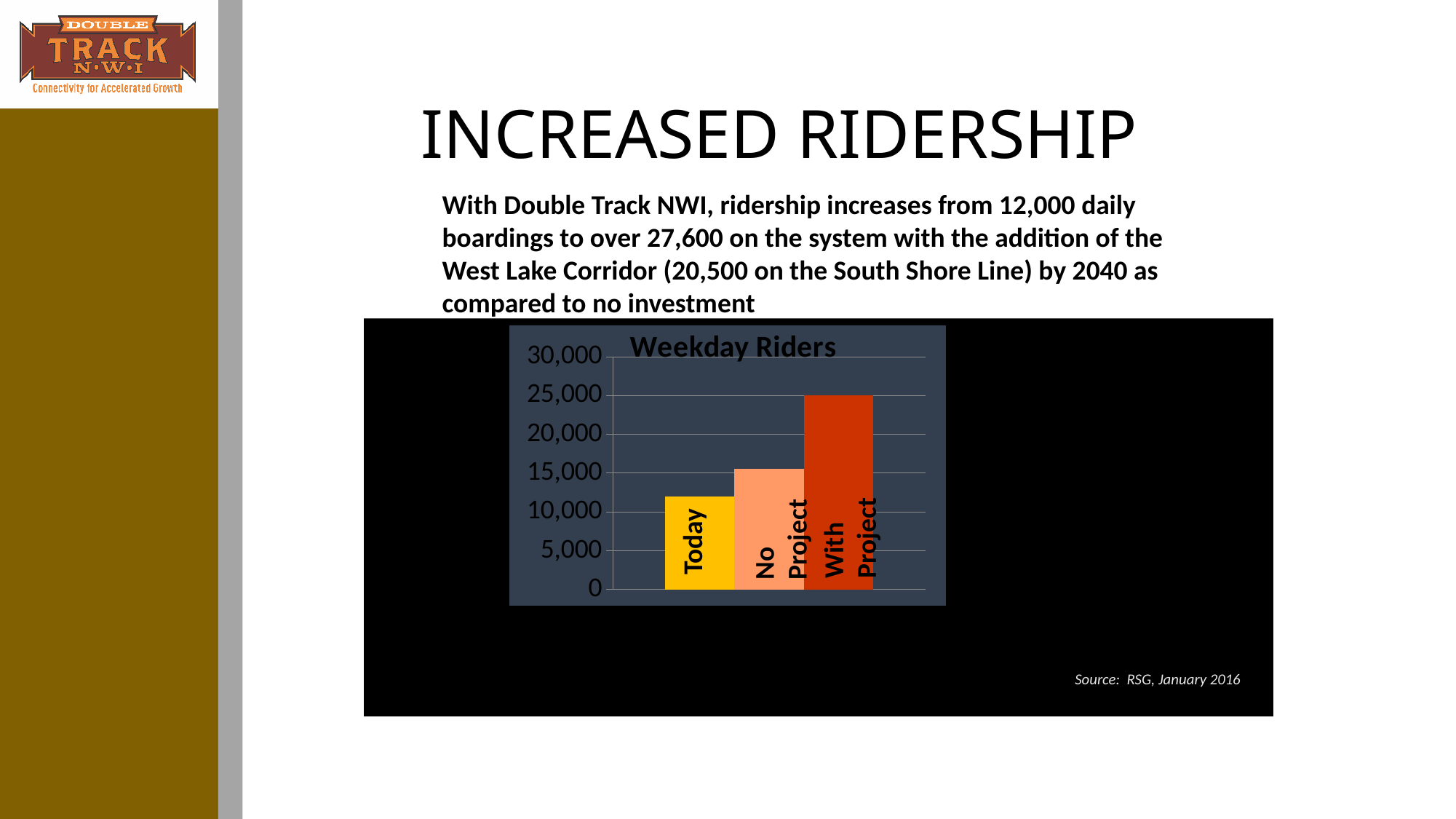
Is the value for With Project greater or less than 20,000? greater Is the value for Today greater or less than 15,000? less Which category has the highest value in the Weekday Riders chart? With Project Is the value for No Project greater or less than 20,000? less What is the title of the chart? Weekday Riders How many bars (categories) does the Weekday Riders chart show? 3 Which category has the lowest value in the Weekday Riders chart? Today What colour is the bar for Today in the Weekday Riders chart? yellow Which is larger in the Weekday Riders chart, the value for No Project or the value for Today? No Project Do the values rise or fall moving from Today to With Project along the x axis? rise What kind of chart is shown on the slide? bar chart